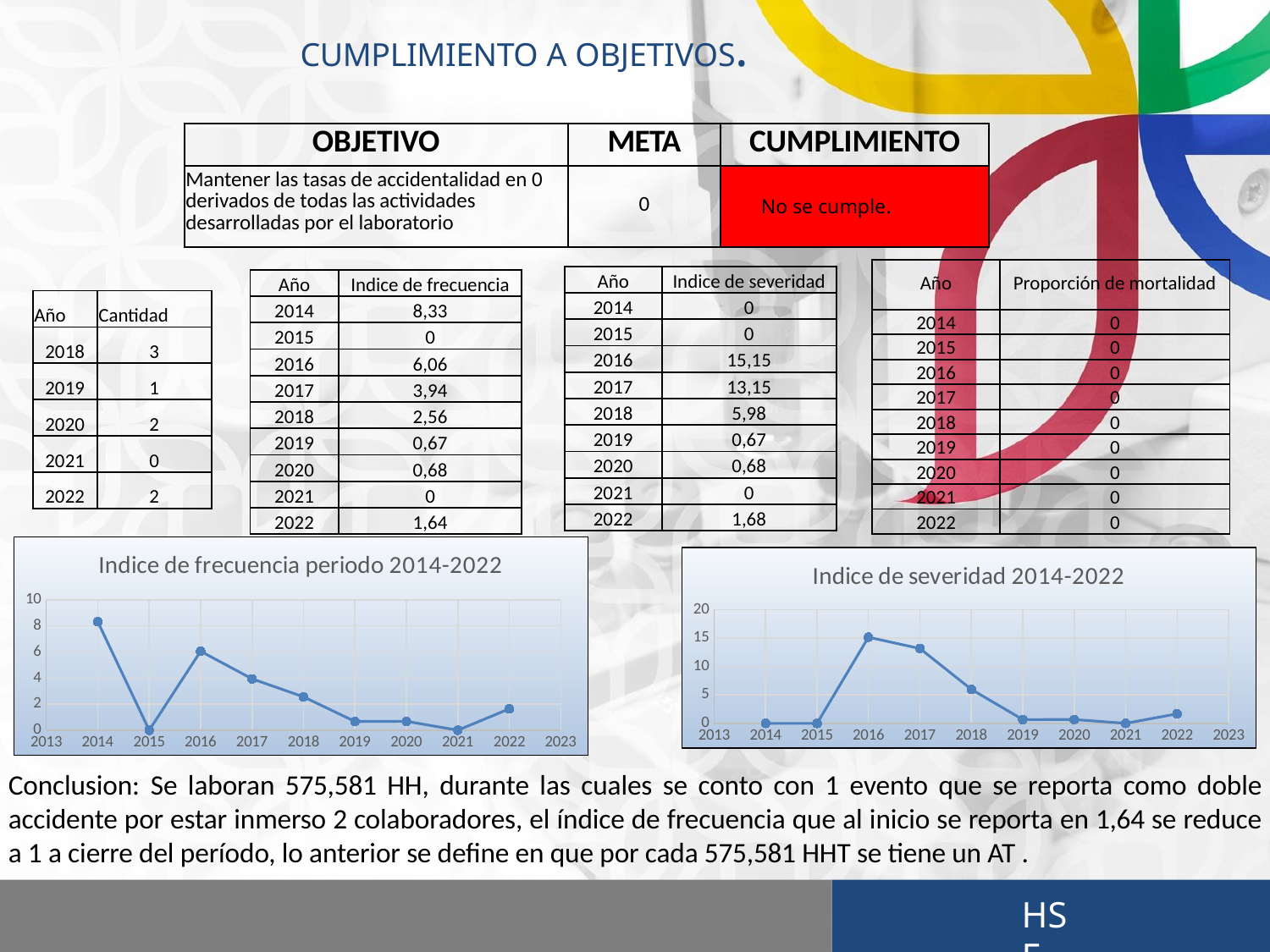
What is the title of the line chart on the right side of the slide? Indice de severidad 2014-2022 What kind of chart is the 'Indice de frecuencia periodo 2014-2022' chart? line chart In the 'Indice de frecuencia periodo 2014-2022' chart, is the value for 2018 greater or less than 2? greater In the 'Indice de severidad 2014-2022' chart, is the value for 2022 greater or less than 5? less In the 'Indice de severidad 2014-2022' chart, do the values rise or fall from 2016 to 2018? fall In the 'Indice de severidad 2014-2022' chart, which year has the highest value? 2016 In the 'Indice de frecuencia periodo 2014-2022' chart, how many data points are plotted? 9 In the 'Indice de severidad 2014-2022' chart, is the value for 2016 greater or less than 10? greater In the 'Indice de frecuencia periodo 2014-2022' chart, which year has the larger value, 2014 or 2016? 2014 In the 'Indice de severidad 2014-2022' chart, which year has the larger value, 2016 or 2018? 2016 In the 'Indice de frecuencia periodo 2014-2022' chart, which year has the highest value? 2014